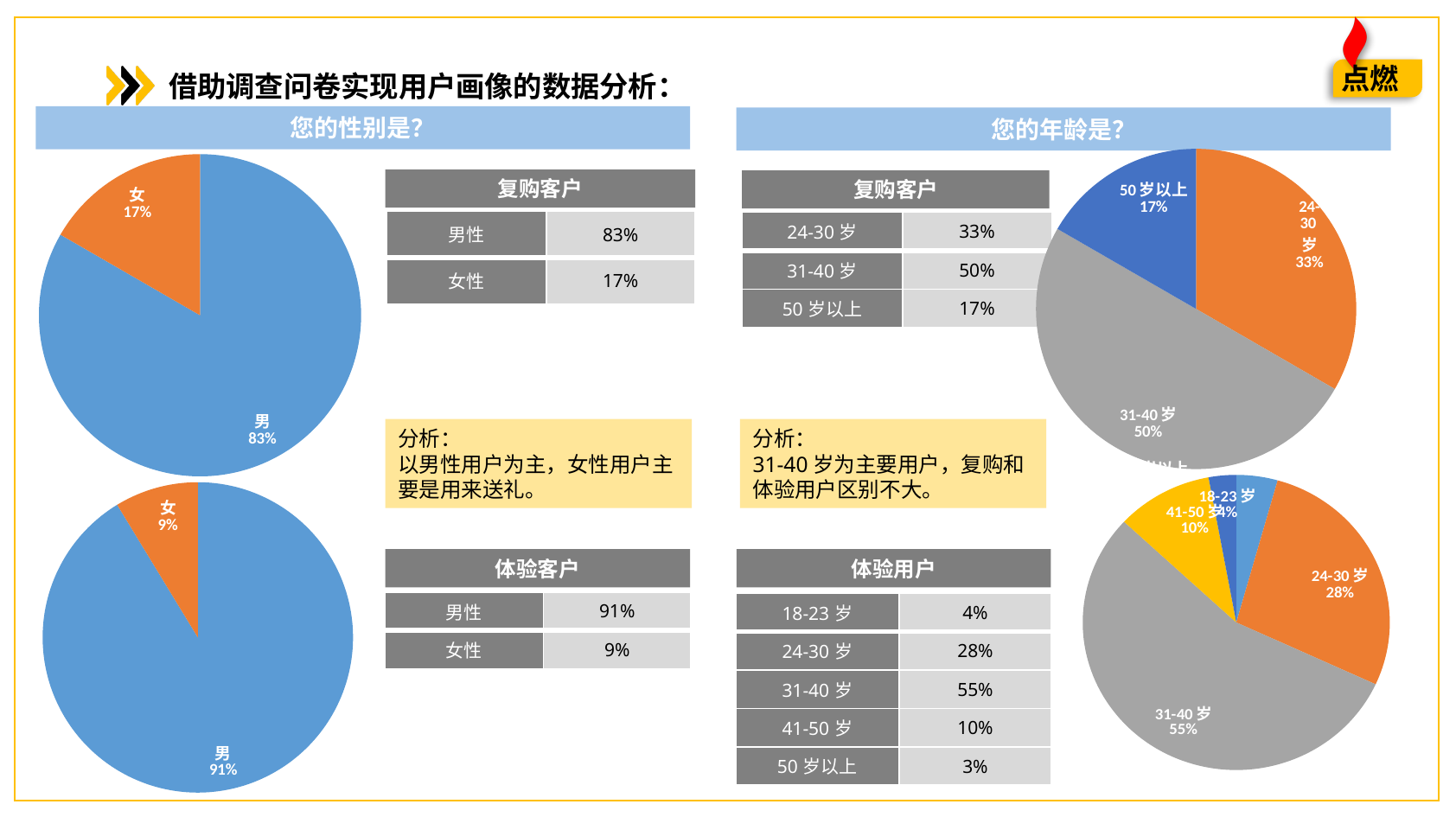
In the bottom-left pie chart (gender of trial customers), what share is labelled for 男? 91% In the top-left pie chart (gender of repeat customers), what share is labelled for 男? 83% In the bottom-right pie chart (age of trial users), what share is labelled for 41-50 岁? 10% In the top-right pie chart (age of repeat customers), what share is labelled for 31-40 岁? 50% In the bottom-right pie chart (age of trial users), which is larger, the 24-30 岁 slice or the 41-50 岁 slice? 24-30 岁 In the bottom-right pie chart (age of trial users), which age group has the largest slice? 31-40 岁 In the top-left pie chart (gender of repeat customers), what share is labelled for 女? 17% In the top-right pie chart (age of repeat customers), what is the difference between the 24-30 岁 share and the 50 岁以上 share? 16% In the top-right pie chart (age of repeat customers), which age group has the smallest slice? 50 岁以上 In the bottom-left pie chart (gender of trial customers), what share is labelled for 女? 9% What type of chart is used for the gender breakdown on the left side of the slide? Pie chart How many slices does the bottom-right pie chart (age of trial users) have? 5